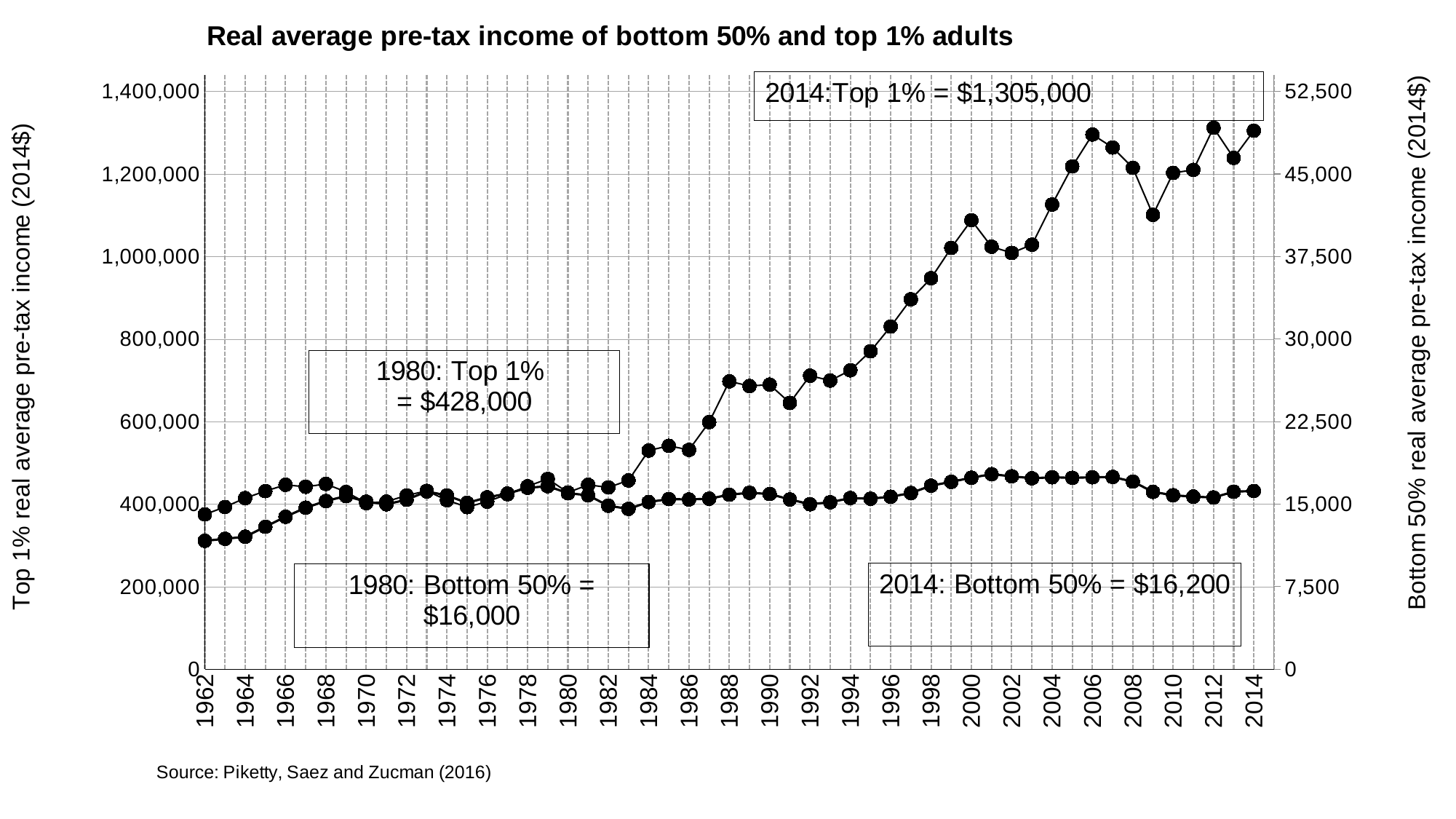
Is the top 1% real average pre-tax income in 2000 greater or less than 1,000,000? greater What was the real average pre-tax income of the bottom 50% in 1980? $16,000 By how much did the bottom 50% real average pre-tax income increase between 1980 and 2014? $200 What was the real average pre-tax income of the bottom 50% in 2014? $16,200 What is the title of the chart? Real average pre-tax income of bottom 50% and top 1% adults Does the top 1% real average pre-tax income generally rise or fall from 1980 to 2014? Rise What kind of chart is shown on the slide? Line chart What was the real average pre-tax income of the top 1% in 2014? $1,305,000 Which is larger: the top 1% income in 1980 or in 2014? 2014 What was the real average pre-tax income of the top 1% in 1980? $428,000 By how much did the top 1% real average pre-tax income increase between 1980 and 2014? $877,000 What source is cited for the chart data? Piketty, Saez and Zucman (2016)